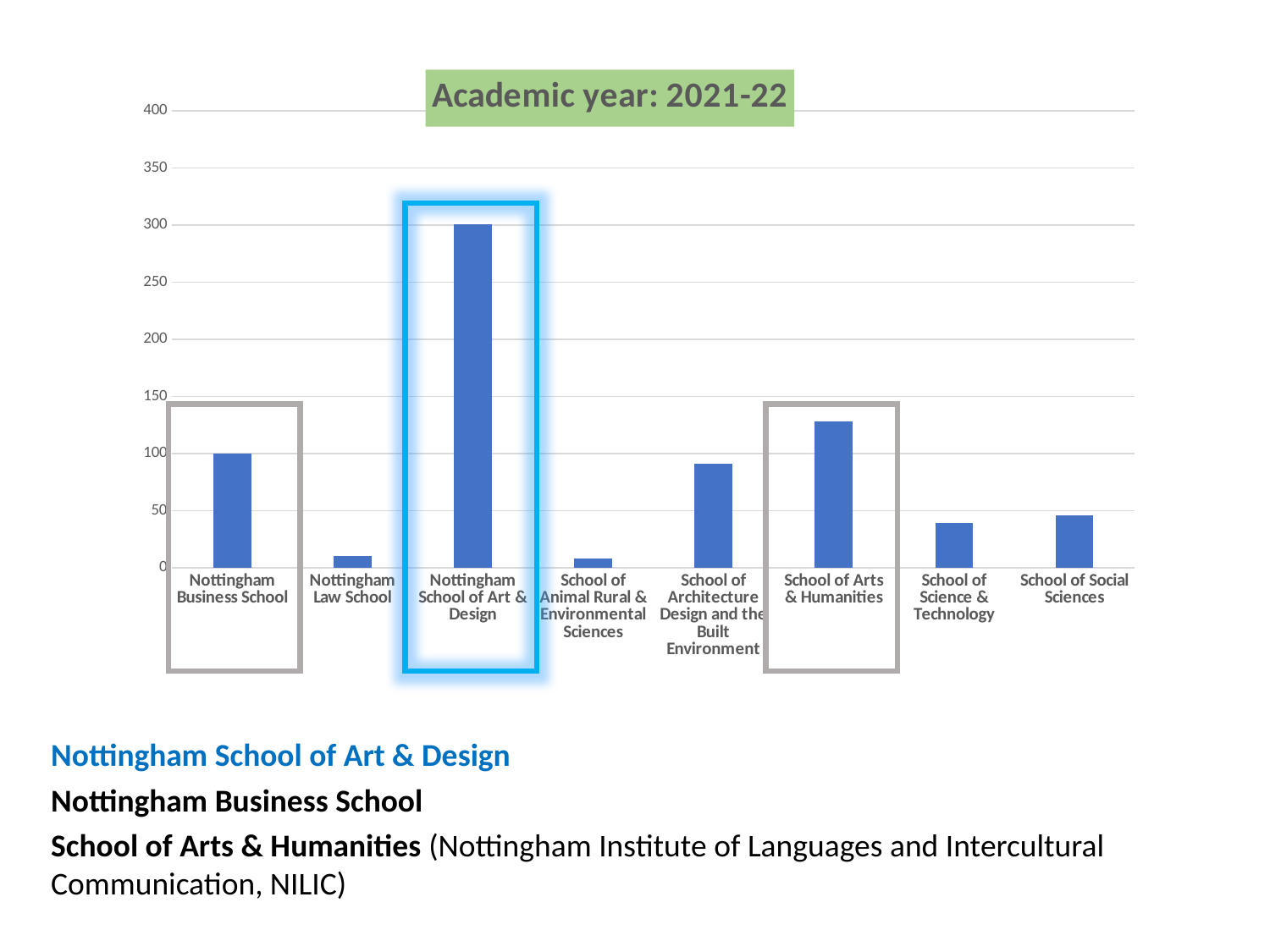
How many schools are shown on the x axis of the chart? 8 Is the value for School of Architecture Design and the Built Environment greater or less than 100? less Which has the larger value, School of Arts & Humanities or School of Architecture Design and the Built Environment? School of Arts & Humanities Is the value for School of Arts & Humanities greater or less than 100? greater Which bar is outlined with a blue highlighted box on the chart? Nottingham School of Art & Design Is the value for Nottingham Law School greater or less than 50? less What kind of chart is shown on the slide? Bar chart Which school has the highest bar in the chart? Nottingham School of Art & Design What is the title of the chart? Academic year: 2021-22 What is the value for Nottingham Business School? 100